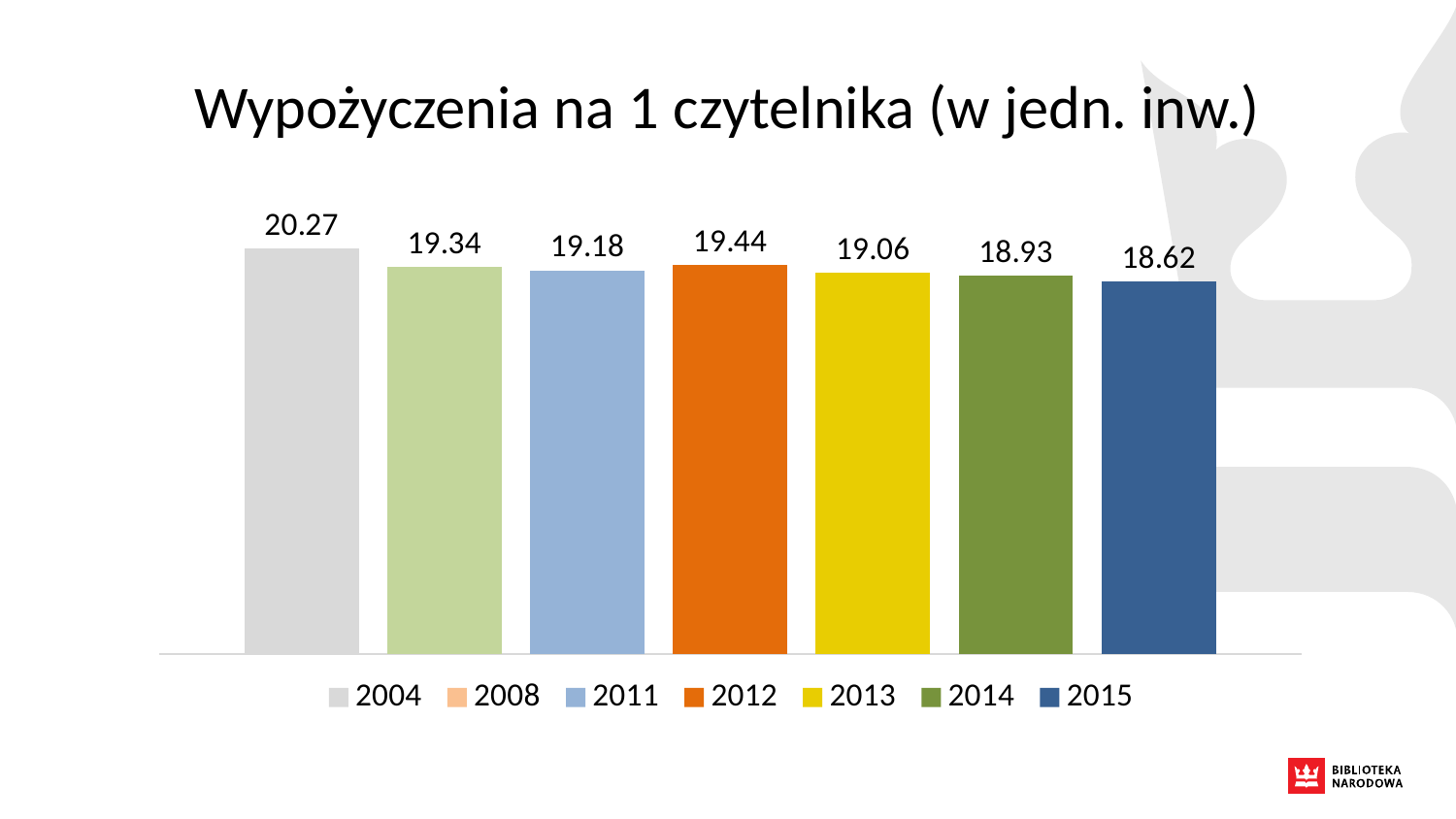
What type of chart is shown on the slide? Bar chart What is the value for 2015? 18.62 What is the value for 2004? 20.27 What is the value for 2013? 19.06 What is the difference between the values for 2004 and 2015? 1.65 How many bars are shown in the chart? 7 Which year has the lowest value? 2015 Which year has the highest value? 2004 Which is larger, the value for 2012 or the value for 2011? 2012 What is the difference between the values for 2012 and 2014? 0.51 How many entries does the legend list? 7 What is the value for 2012? 19.44